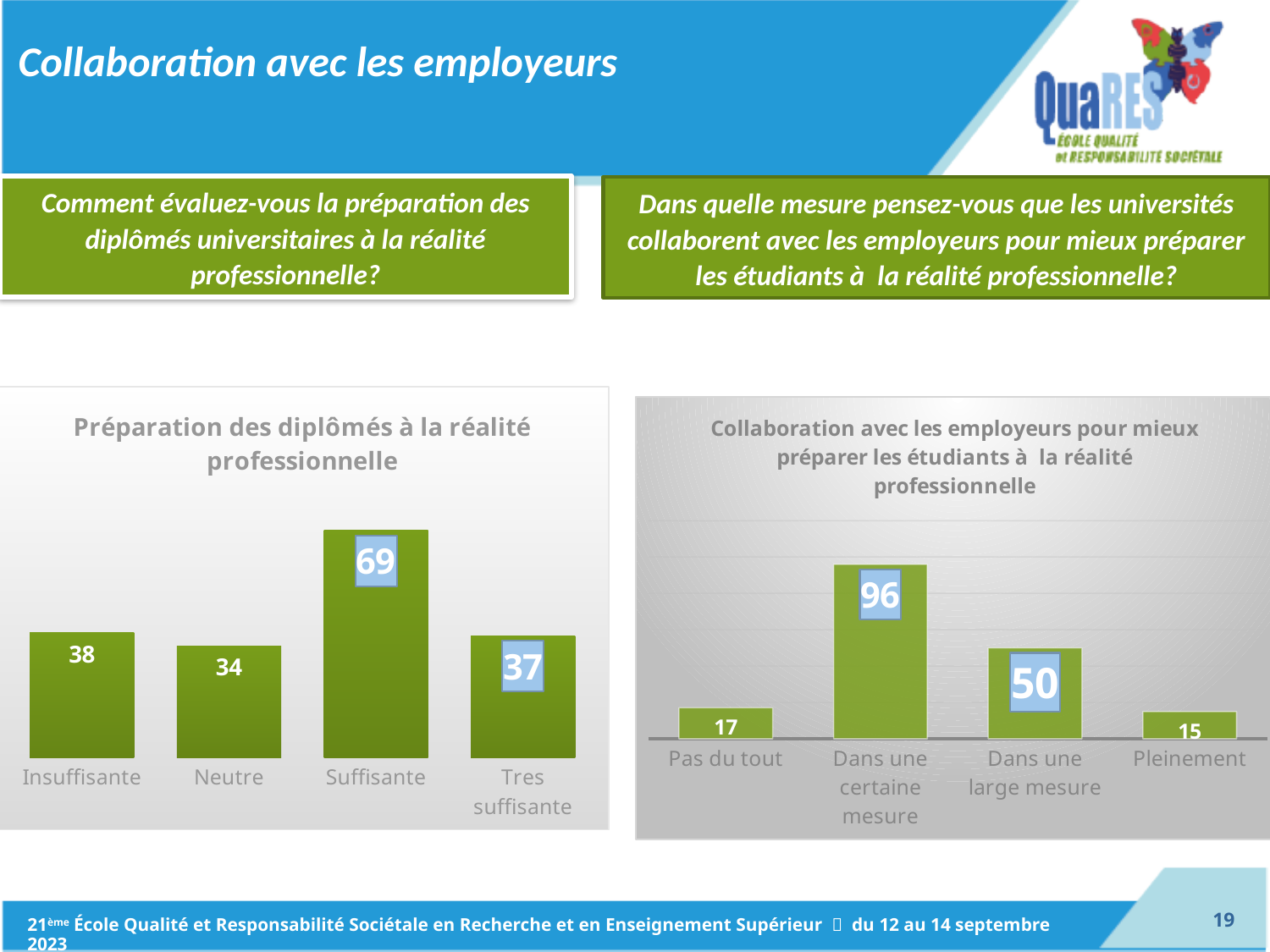
In the left chart 'Préparation des diplômés à la réalité professionnelle', how many categories are shown? 4 In the left chart 'Préparation des diplômés à la réalité professionnelle', what is the value for Neutre? 34 In the right chart 'Collaboration avec les employeurs pour mieux préparer les étudiants à la réalité professionnelle', what is the value for Dans une large mesure? 50 What kind of chart is the right chart 'Collaboration avec les employeurs pour mieux préparer les étudiants à la réalité professionnelle'? Bar chart In the right chart 'Collaboration avec les employeurs pour mieux préparer les étudiants à la réalité professionnelle', what is the difference between Dans une certaine mesure and Dans une large mesure? 46 In the left chart 'Préparation des diplômés à la réalité professionnelle', which category has the lowest value? Neutre In the right chart 'Collaboration avec les employeurs pour mieux préparer les étudiants à la réalité professionnelle', which category has the lowest value? Pleinement In the left chart 'Préparation des diplômés à la réalité professionnelle', what is the value for Suffisante? 69 In the right chart 'Collaboration avec les employeurs pour mieux préparer les étudiants à la réalité professionnelle', which is larger, Pas du tout or Pleinement? Pas du tout In the right chart 'Collaboration avec les employeurs pour mieux préparer les étudiants à la réalité professionnelle', which category has the highest value? Dans une certaine mesure What is the title of the left chart? Préparation des diplômés à la réalité professionnelle In the left chart 'Préparation des diplômés à la réalité professionnelle', what is the difference between Suffisante and Insuffisante? 31